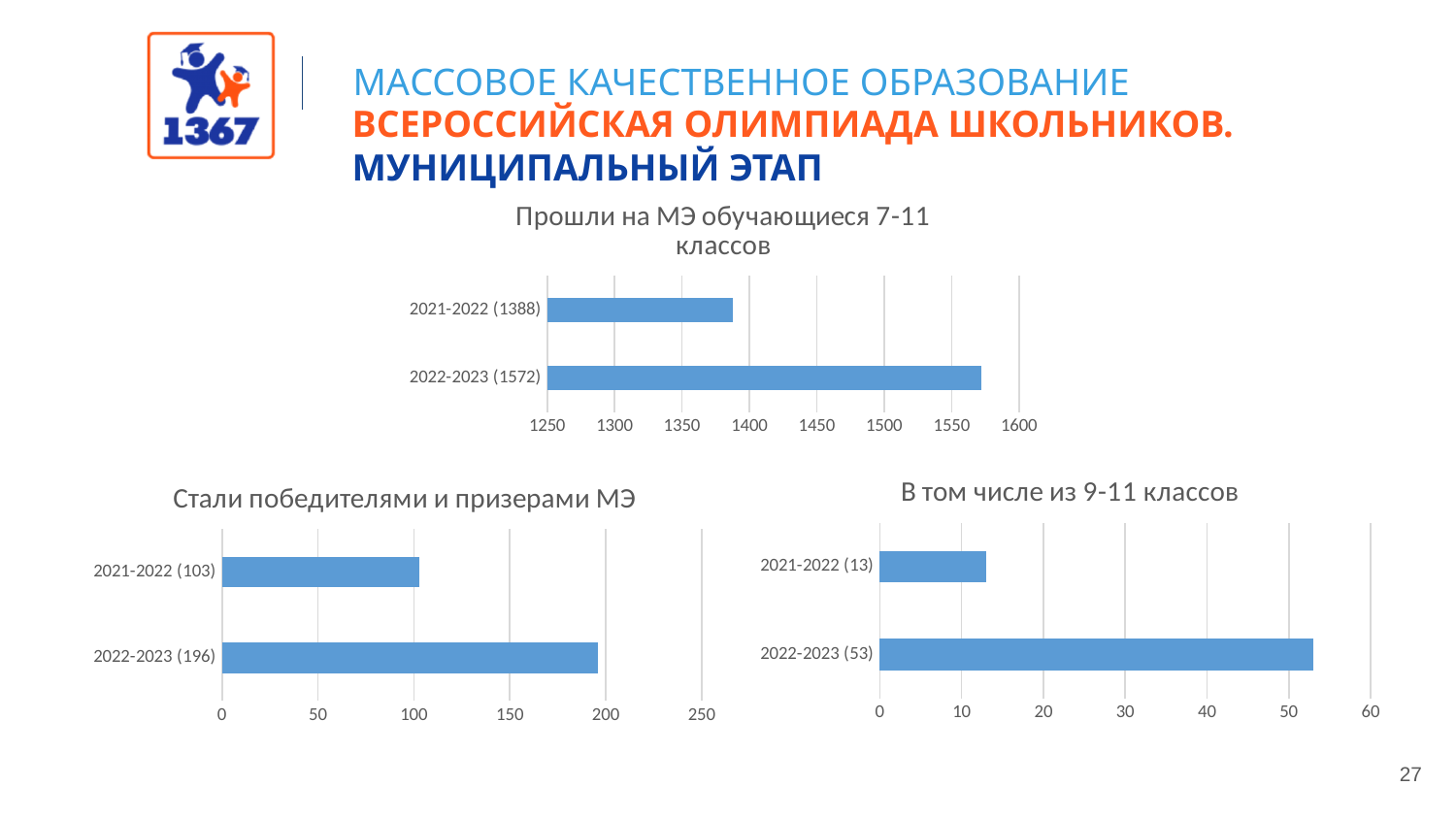
In the chart 'Прошли на МЭ обучающиеся 7-11 классов', what is the value for 2021-2022? 1388 In the chart 'Прошли на МЭ обучающиеся 7-11 классов', what is the value for 2022-2023? 1572 In the chart 'Прошли на МЭ обучающиеся 7-11 классов', what is the difference between the 2022-2023 and 2021-2022 values? 184 In the chart 'В том числе из 9-11 классов', is the value for 2022-2023 greater or less than 50? greater In the chart 'Стали победителями и призерами МЭ', which year has the lowest value? 2021-2022 In the chart 'В том числе из 9-11 классов', what is the value for 2021-2022? 13 In the chart 'В том числе из 9-11 классов', which year has the highest value? 2022-2023 How many charts are shown on the slide? 3 What type of chart is 'Прошли на МЭ обучающиеся 7-11 классов'? bar chart In the chart 'Стали победителями и призерами МЭ', what is the value for 2022-2023? 196 How many bars are shown in the chart 'Стали победителями и призерами МЭ'? 2 In the chart 'Стали победителями и призерами МЭ', what is the difference between the 2022-2023 and 2021-2022 values? 93